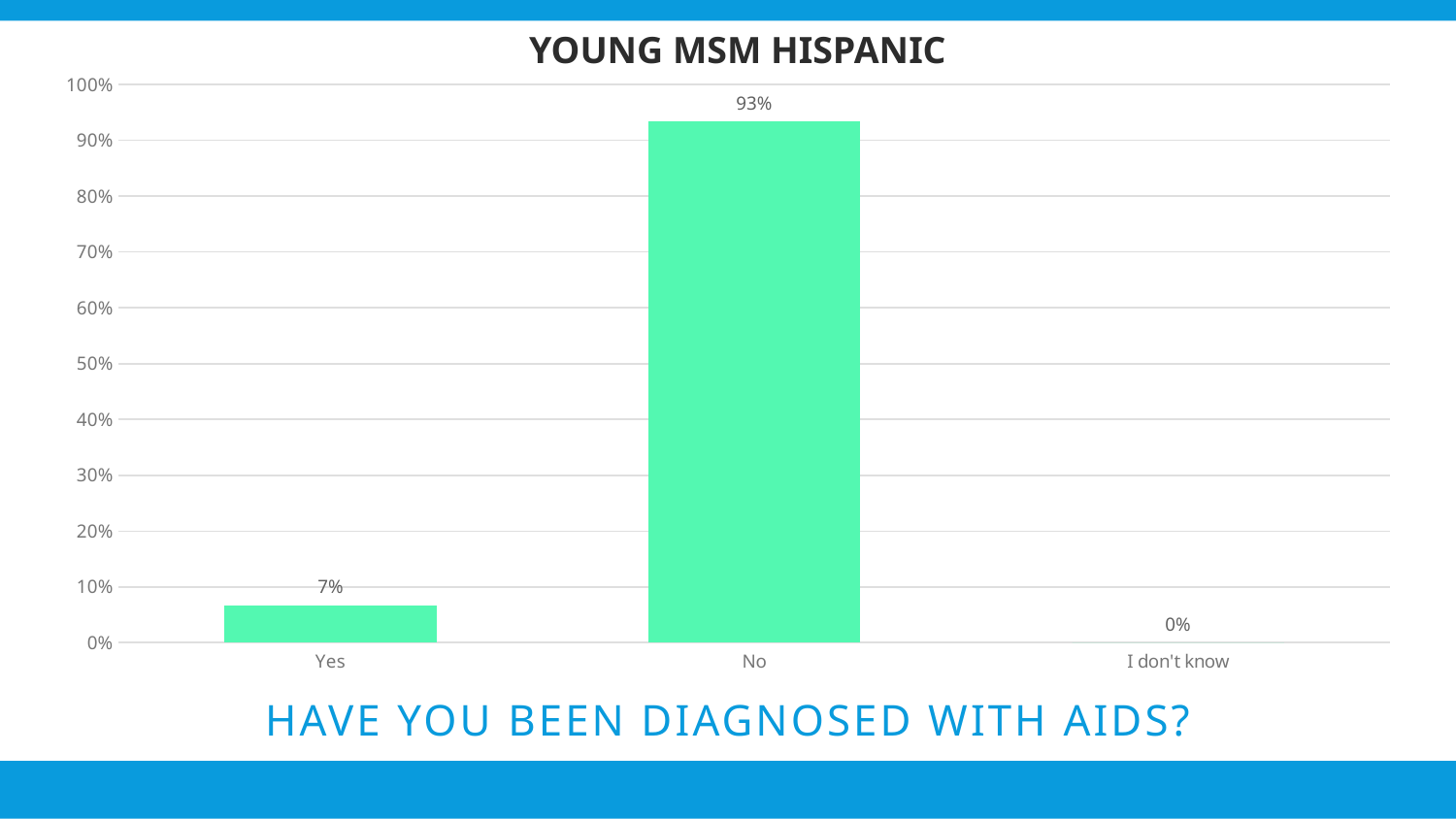
What is the difference between the values for "No" and "Yes"? 86% Is the value for "No" greater or less than 90%? greater Which category has the highest value? No What kind of chart is shown on the slide? Bar chart What is the value for "Yes"? 7% How many categories are shown on the x axis? 3 What is the title of the chart? YOUNG MSM HISPANIC Which is larger, the value for "Yes" or the value for "No"? No Which category has the lowest value? I don't know Is the value for "Yes" greater or less than 10%? less What is the value for "No"? 93% What is the value for "I don't know"? 0%